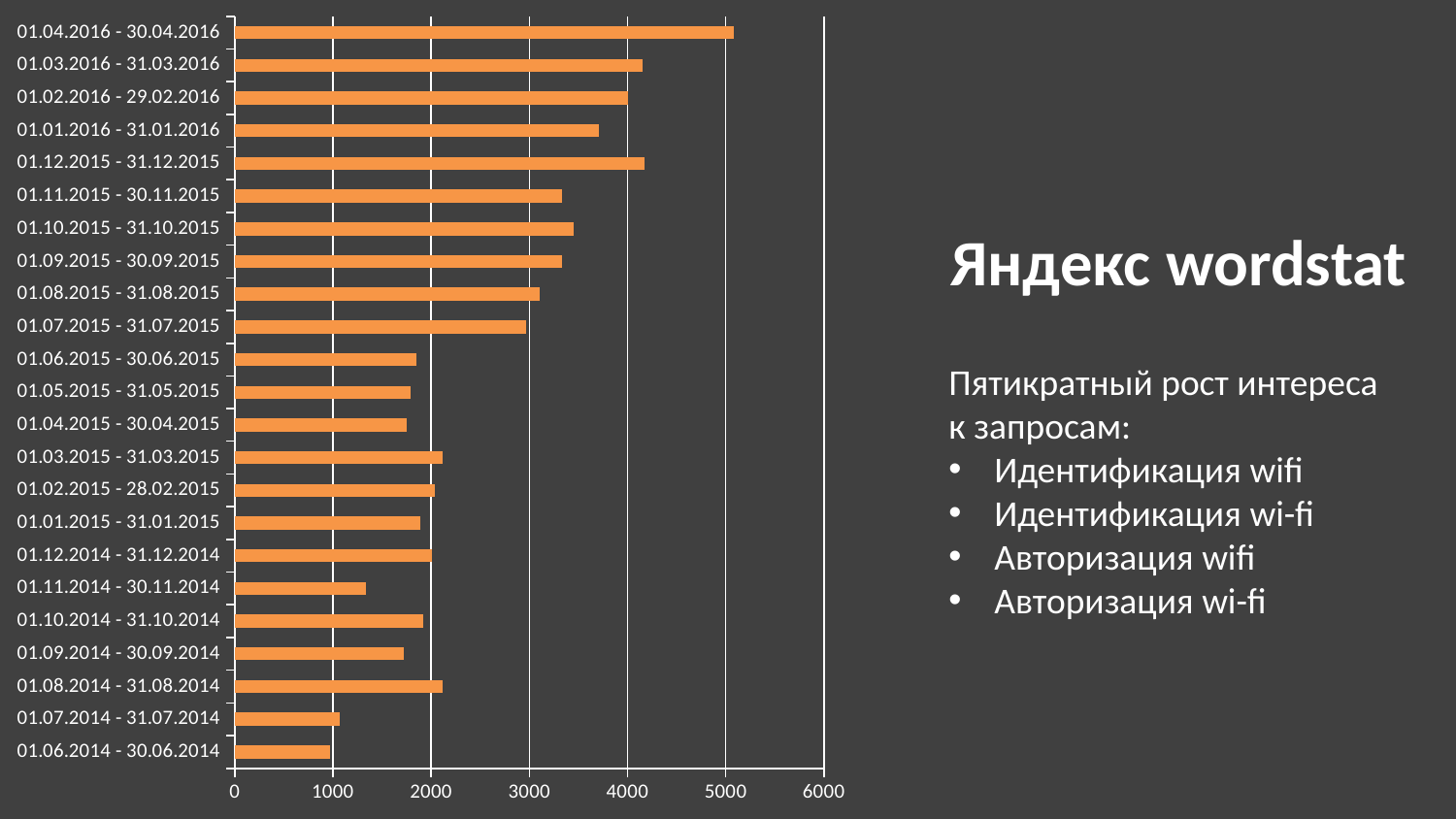
What colour are the bars in the chart? orange Do the values generally rise or fall from the earliest period (June 2014, bottom) to the latest period (April 2016, top)? rise Which is larger: the value for 01.12.2015 - 31.12.2015 or for 01.11.2015 - 30.11.2015? 01.12.2015 - 31.12.2015 Is the value for 01.12.2015 - 31.12.2015 greater or less than 3000? greater Which period has the highest value in the chart? 01.04.2016 - 30.04.2016 Is the value for 01.04.2016 - 30.04.2016 greater or less than 4000? greater Is the value for 01.01.2016 - 31.01.2016 greater or less than 4000? less What kind of chart is shown on the slide? bar chart Which is larger: the value for 01.04.2016 - 30.04.2016 or for 01.03.2016 - 31.03.2016? 01.04.2016 - 30.04.2016 How many time periods (categories) are plotted in the chart? 23